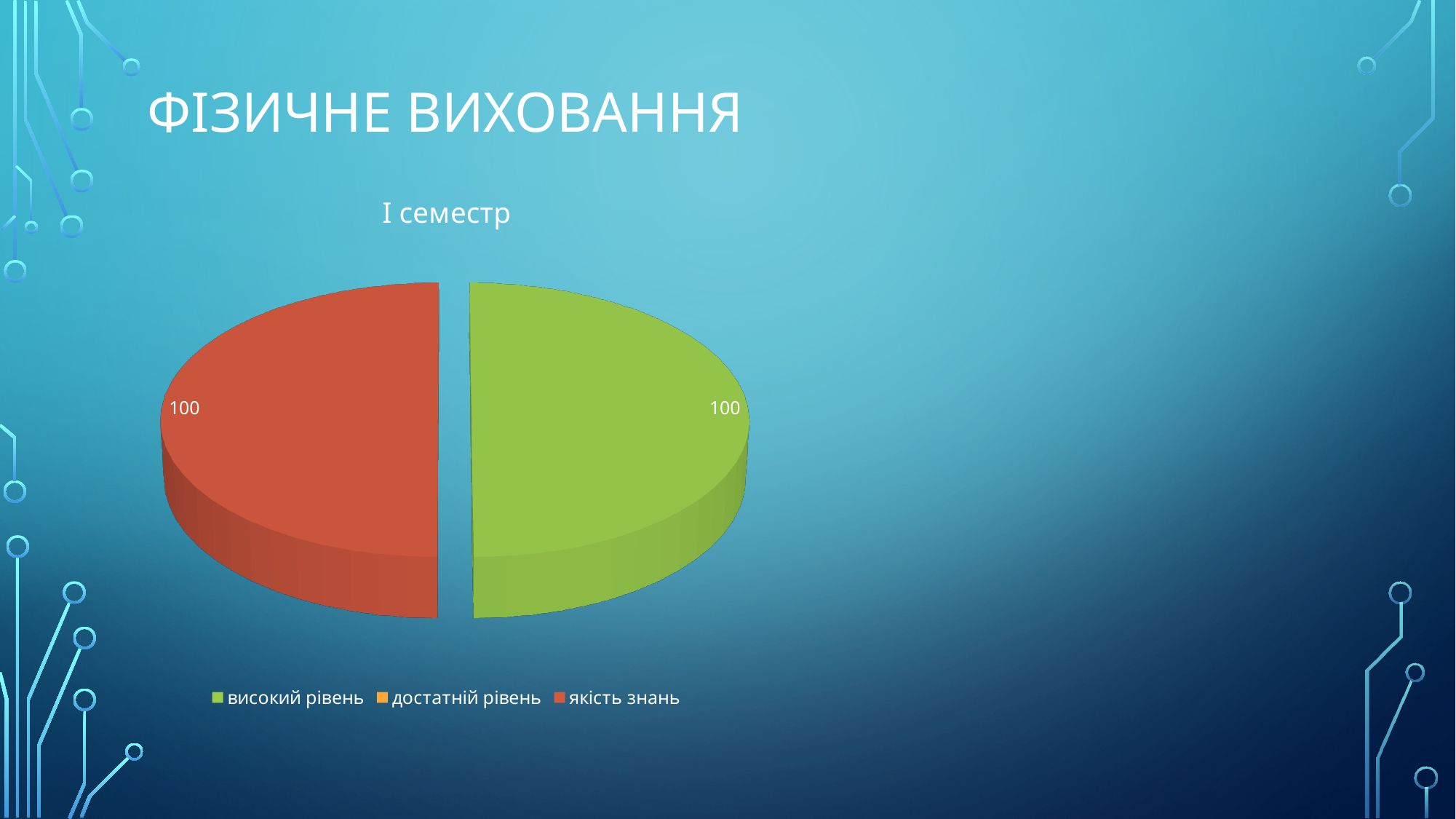
Is the value for "високий рівень" larger than, smaller than, or equal to the value for "якість знань"? equal What colour is the "якість знань" slice? red How many entries does the chart legend list? 3 What is the value shown for the "якість знань" slice? 100 What kind of chart is shown on the slide? pie chart How many slices are visible in the pie chart? 2 What is the title of the chart? І семестр What is the value shown for the "високий рівень" slice? 100